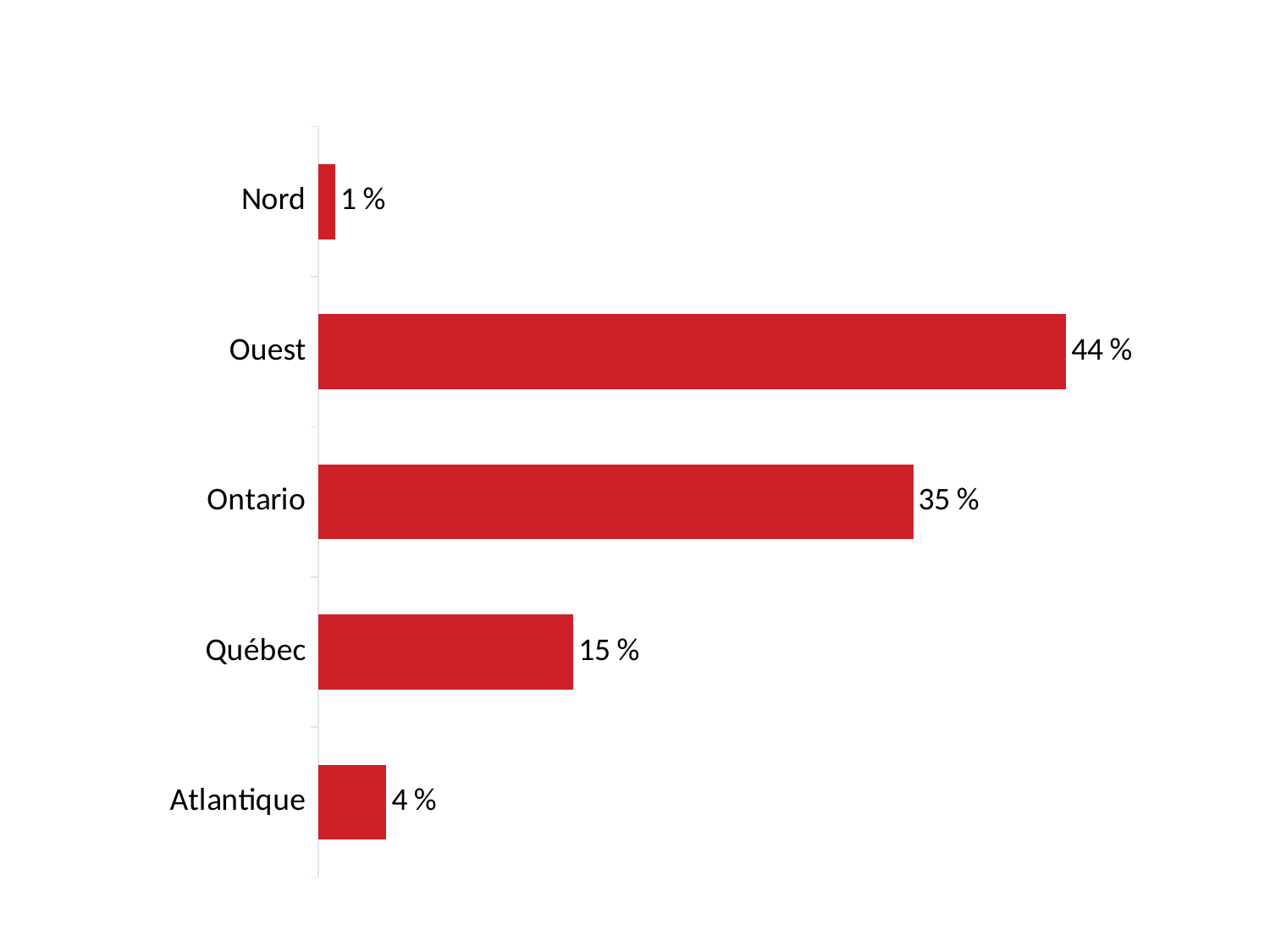
What is the value for Nord? 1 % Which has a larger value, Ontario or Québec? Ontario What is the difference between the values for Ouest and Ontario? 9 % What is the difference between the values for Québec and Atlantique? 11 % What is the value for Québec? 15 % What kind of chart is this? Bar chart Which region has the lowest value? Nord What is the value for Atlantique? 4 % How many regions are shown in the chart? 5 What is the value for Ontario? 35 % What is the value for Ouest? 44 % Which region has the highest value? Ouest